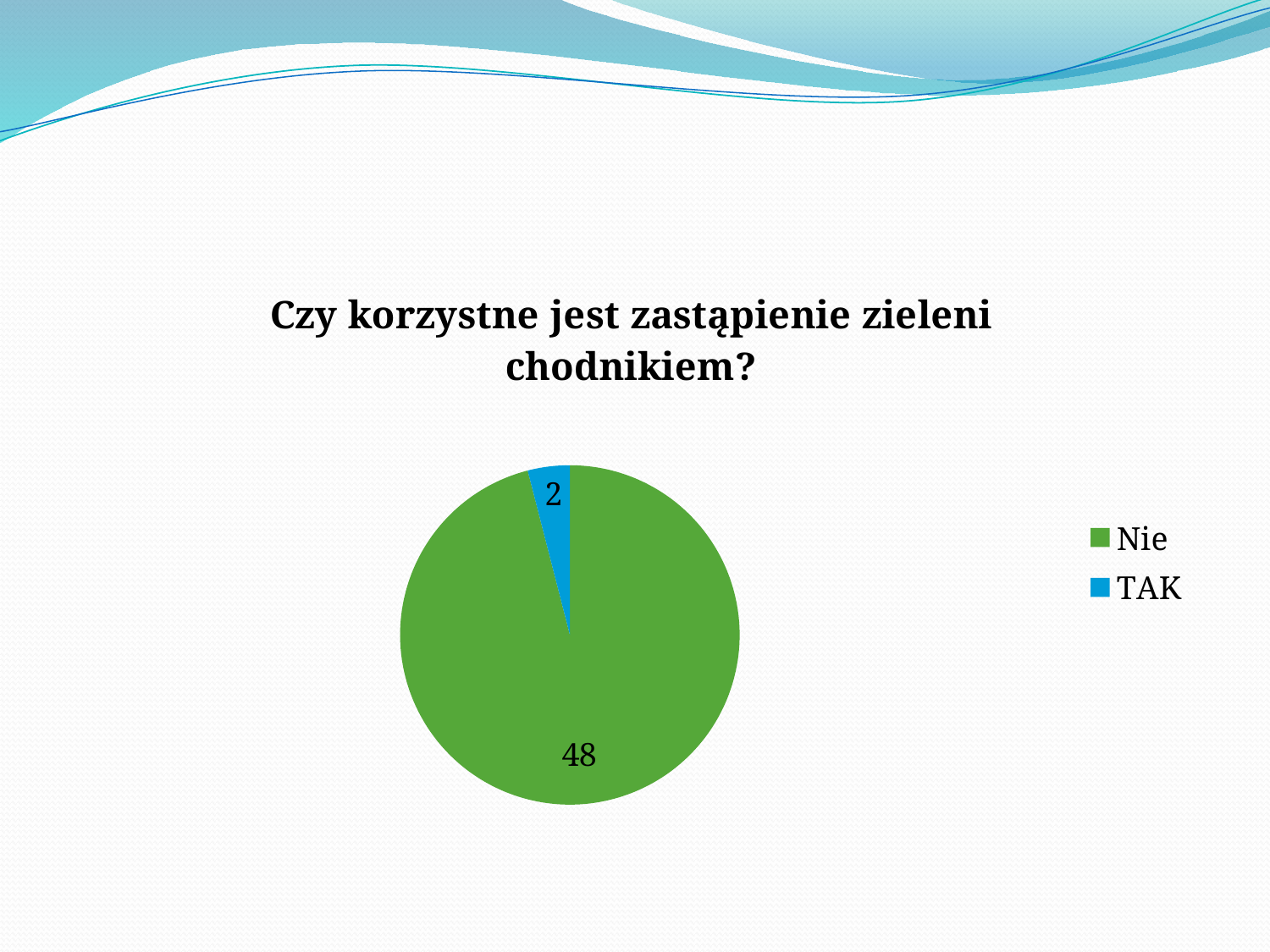
Which category has the smallest slice? TAK What kind of chart is shown on the slide? pie chart Which category has the largest slice? Nie What share of the pie does "TAK" represent? 4% What share of the pie does "Nie" represent? 96% What is the difference between the values for "Nie" and "TAK"? 46 Which is larger, the value for "Nie" or the value for "TAK"? Nie What is the value for "Nie"? 48 How many categories does the pie chart have? 2 What is the value for "TAK"? 2 What is the title of the chart? Czy korzystne jest zastąpienie zieleni chodnikiem? What is the total of all slices in the pie chart? 50